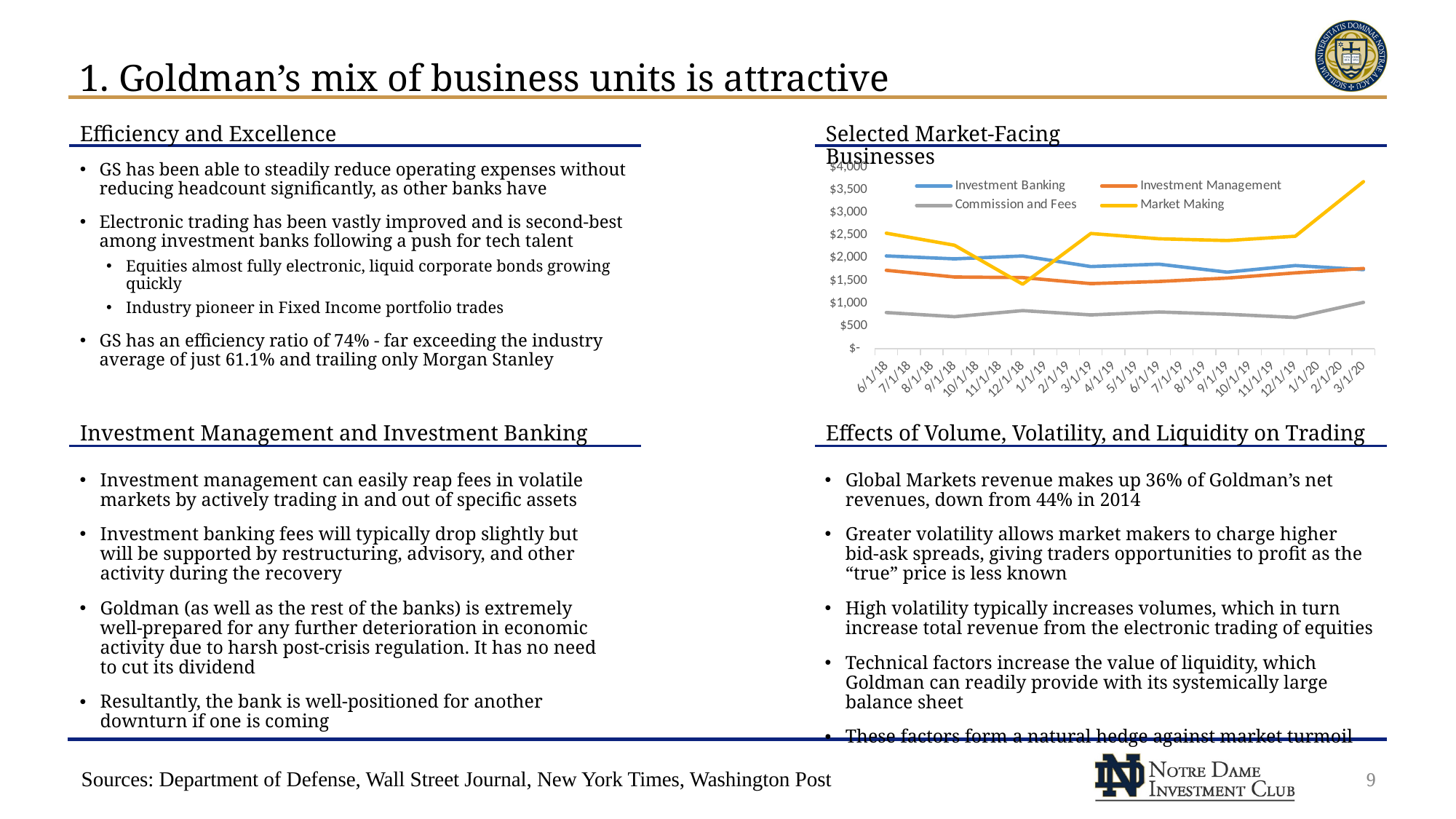
In the 'Selected Market-Facing Businesses' chart, is the Market Making value at 12/1/18 greater or less than $2,000? less What colour is the Market Making line in the 'Selected Market-Facing Businesses' chart? Yellow What is the first date label on the x axis of the 'Selected Market-Facing Businesses' chart? 6/1/18 In the 'Selected Market-Facing Businesses' chart, does the Market Making series rise or fall between 12/1/19 and 3/1/20? Rise Which series in the 'Selected Market-Facing Businesses' chart has the highest value at 3/1/20? Market Making What kind of chart is shown under the heading 'Selected Market-Facing Businesses'? Line chart How many series does the legend of the 'Selected Market-Facing Businesses' chart list? 4 Which series in the 'Selected Market-Facing Businesses' chart has the lowest value at 6/1/18? Commission and Fees In the 'Selected Market-Facing Businesses' chart, is the Market Making value at 3/1/20 greater or less than $3,000? greater In the 'Selected Market-Facing Businesses' chart, is the Investment Management value at 6/1/18 greater or less than $1,500? greater In the 'Selected Market-Facing Businesses' chart, which is larger at 6/1/18: Investment Banking or Investment Management? Investment Banking